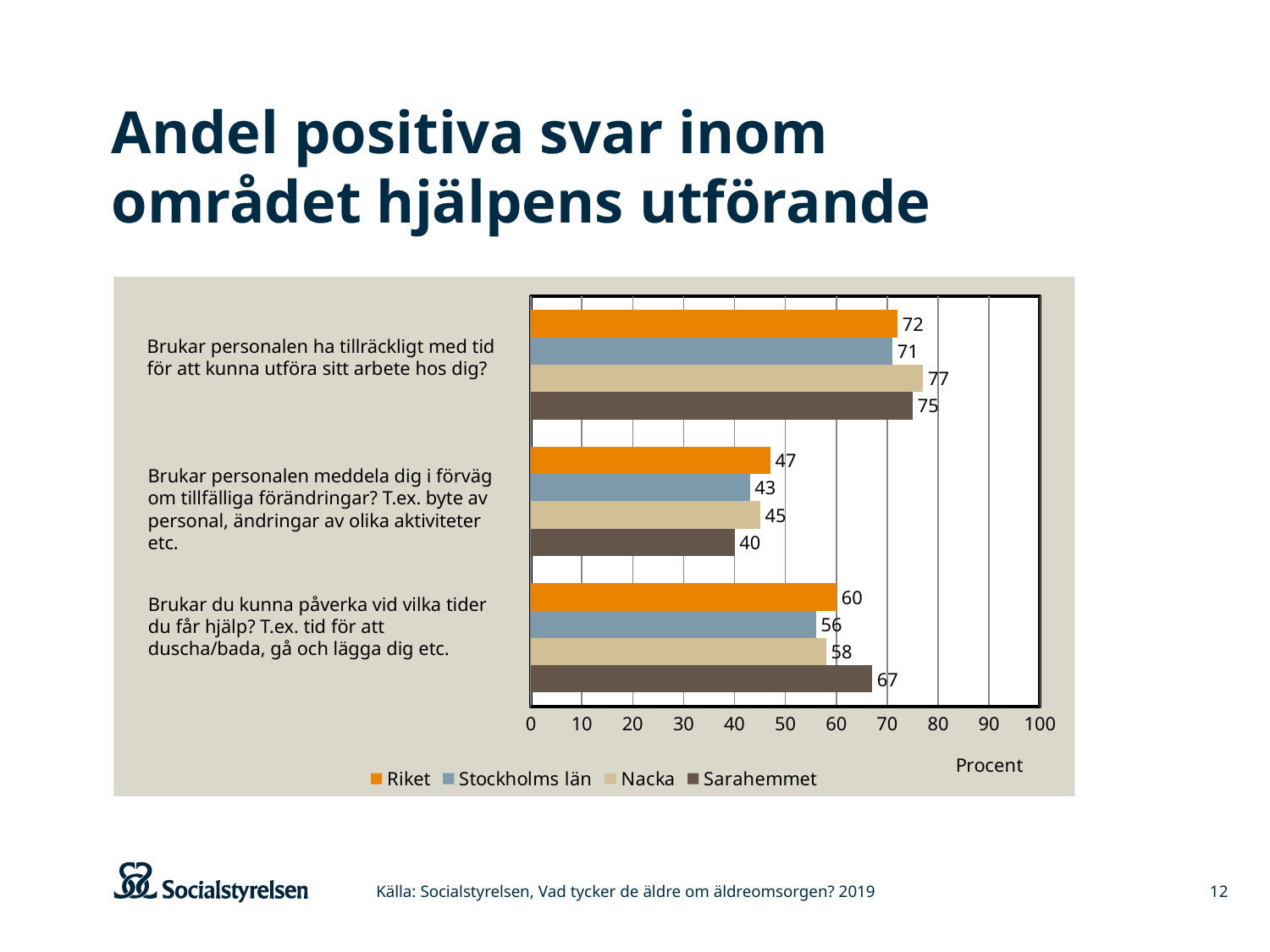
How many question categories are shown on the chart? 3 What value is shown for Sarahemmet on the question "Brukar du kunna påverka vid vilka tider du får hjälp?" 67 How many series does the legend list? 4 What value is shown for Stockholms län on the question "Brukar personalen meddela dig i förväg om tillfälliga förändringar?" 43 What value is shown for Nacka on the question "Brukar personalen ha tillräckligt med tid för att kunna utföra sitt arbete hos dig?" 77 What kind of chart is shown on the slide? Bar chart Which series has the highest value on the question "Brukar personalen ha tillräckligt med tid för att kunna utföra sitt arbete hos dig?" Nacka Which series is shown in orange in the legend? Riket Which series has the lowest value on the question "Brukar personalen meddela dig i förväg om tillfälliga förändringar?" Sarahemmet What is the difference between the Sarahemmet and Riket values on the question "Brukar du kunna påverka vid vilka tider du får hjälp?" 7 On the question "Brukar personalen meddela dig i förväg om tillfälliga förändringar?", which is larger: the value for Riket or the value for Nacka? Riket What is the label of the horizontal axis? Procent